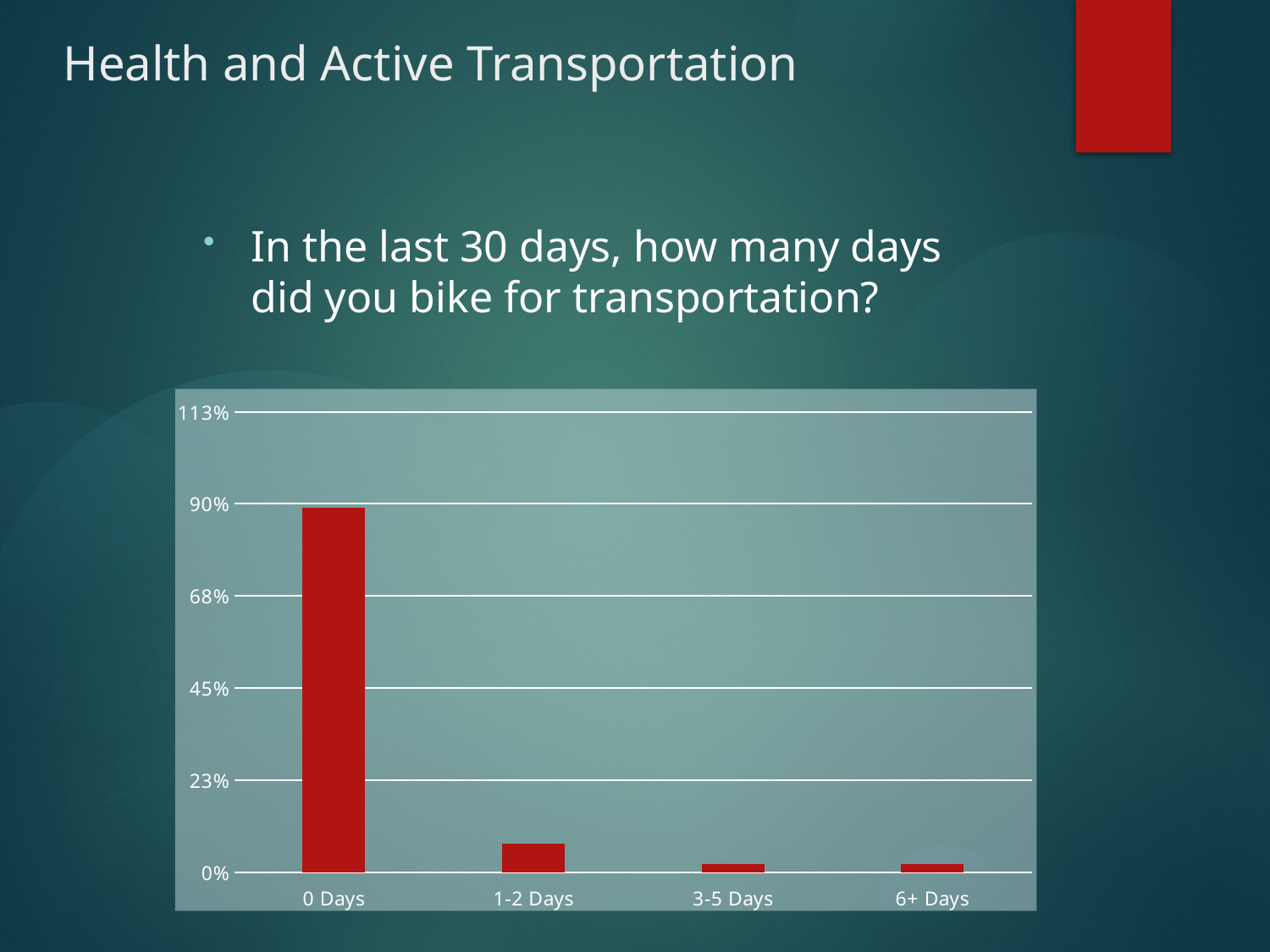
What is the highest value labelled on the y axis of the chart? 113% Is the value for 3-5 Days greater or less than 23%? less Which is larger, the value for 0 Days or the value for 1-2 Days? 0 Days Is the value for 6+ Days greater or less than 45%? less How many categories are shown on the x axis of the chart? 4 Is the value for 0 Days greater or less than 68%? greater Do the values generally rise or fall moving from 0 Days to 6+ Days along the x axis? fall Which category has the highest value in the chart? 0 Days Which is larger, the value for 1-2 Days or the value for 3-5 Days? 1-2 Days What kind of chart is shown on the slide? bar chart What colour are the bars in the chart? red